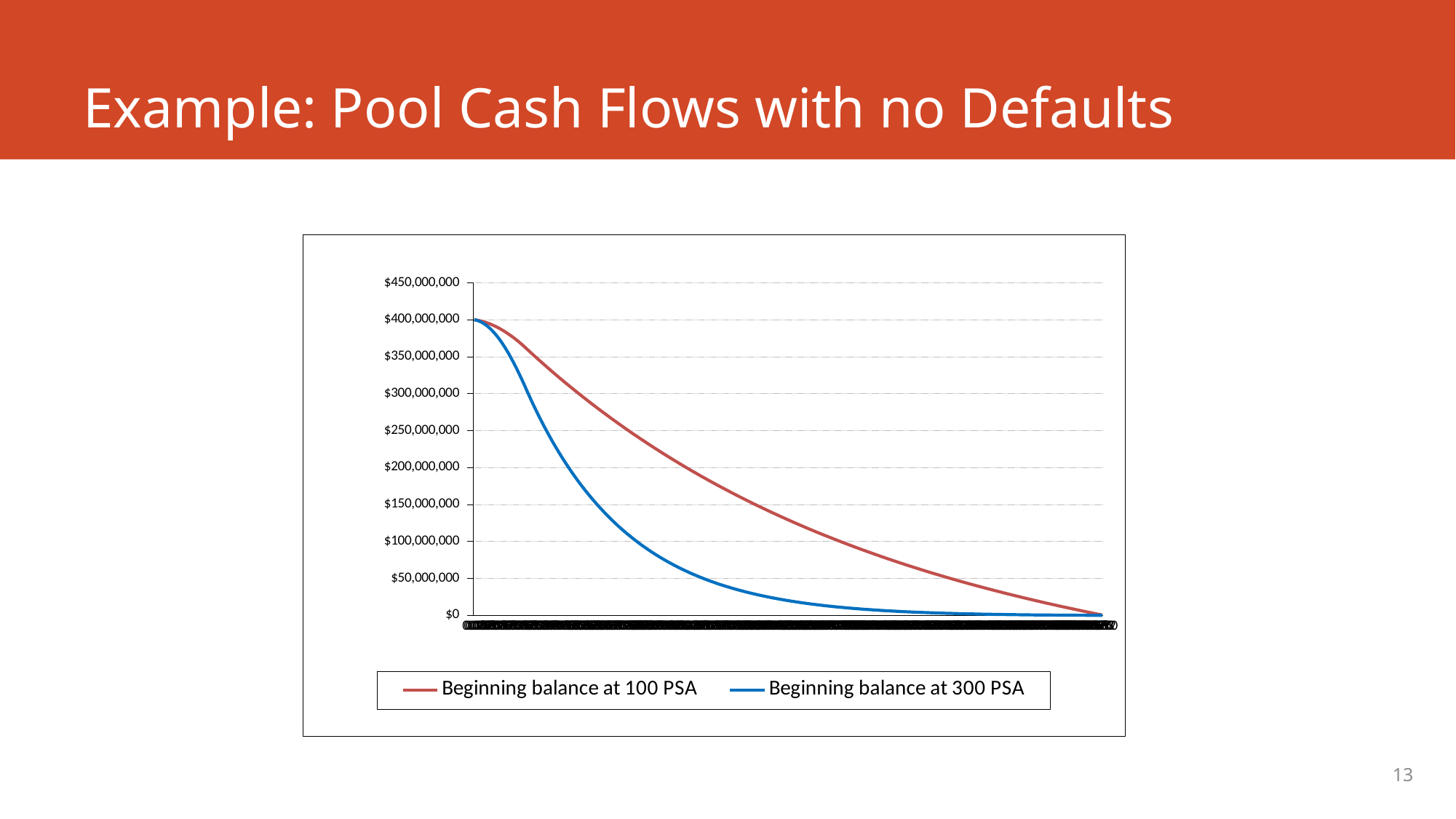
Do the values of the 'Beginning balance at 100 PSA' series rise or fall along the x axis? fall What are the two series named in the legend? Beginning balance at 100 PSA; Beginning balance at 300 PSA At the midpoint of the x axis, is the value for 'Beginning balance at 100 PSA' greater or less than $100,000,000? greater At what value do both series start at the left of the x axis? $400,000,000 Do the values of the 'Beginning balance at 300 PSA' series rise or fall along the x axis? fall Which colour is used for the 'Beginning balance at 300 PSA' line? blue How many series does the legend list? 2 Which series declines faster, 'Beginning balance at 100 PSA' or 'Beginning balance at 300 PSA'? Beginning balance at 300 PSA What kind of chart is shown on the slide? line chart At the midpoint of the x axis, is the value for 'Beginning balance at 300 PSA' greater or less than $50,000,000? less At the midpoint of the x axis, which series has the larger value, 'Beginning balance at 100 PSA' or 'Beginning balance at 300 PSA'? Beginning balance at 100 PSA